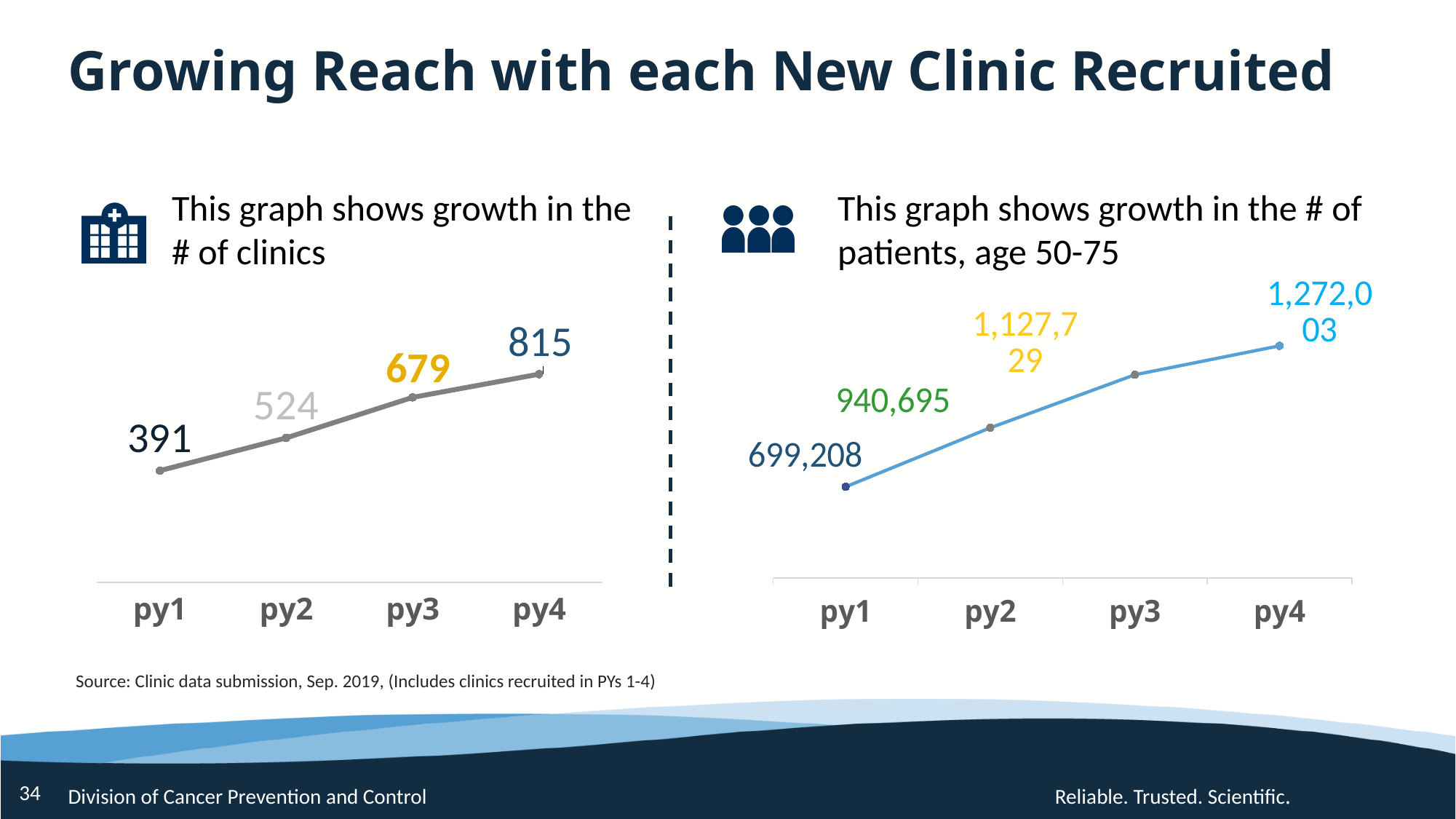
In the right chart (number of patients, age 50-75), do the values rise or fall from py1 to py4? Rise What type of chart is the left chart (number of clinics)? Line chart In the right chart (number of patients, age 50-75), what is the difference between the py3 and py2 values? 187,034 In the left chart (number of clinics), what is the difference between the py4 and py1 values? 424 In the left chart (number of clinics), what is the value for py1? 391 How many data points are plotted in the right chart (number of patients, age 50-75)? 4 In the left chart (number of clinics), which period has the highest value? py4 In the right chart (number of patients, age 50-75), which period has the lowest value? py1 In the left chart (number of clinics), which is larger, the value for py2 or the value for py3? py3 In the left chart (number of clinics), what is the value for py3? 679 In the right chart (number of patients, age 50-75), what is the value for py2? 940,695 In the right chart (number of patients, age 50-75), what is the value for py4? 1,272,003